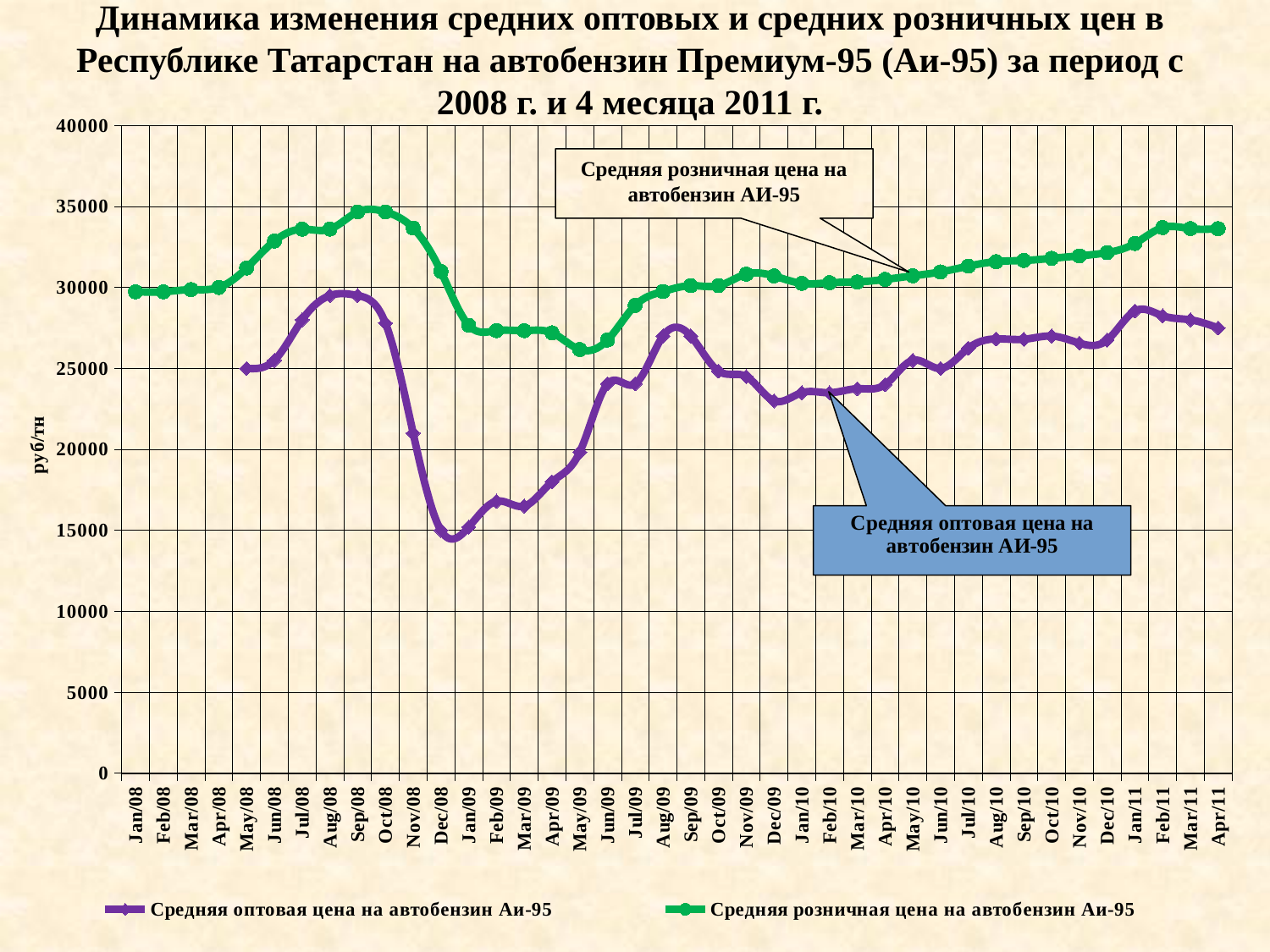
How many months (points) are plotted along the x axis? 40 What is the label of the vertical axis? руб/тн Is the average retail price in Sep/08 greater or less than 30000? greater In which month is the average retail price (Средняя розничная цена) at its lowest? May/09 Which series is drawn in green? Средняя розничная цена на автобензин Аи-95 What kind of chart is shown on the slide? line chart In which month is the average wholesale price (Средняя оптовая цена) at its lowest? Dec/08 Does the average wholesale price rise or fall from Aug/08 to Dec/08? fall Is the average wholesale price in Dec/08 greater or less than 20000? less In Dec/08, which is larger: the average wholesale price or the average retail price? the average retail price How many series does the legend list? 2 Is the average wholesale price in Jan/11 greater or less than 25000? greater